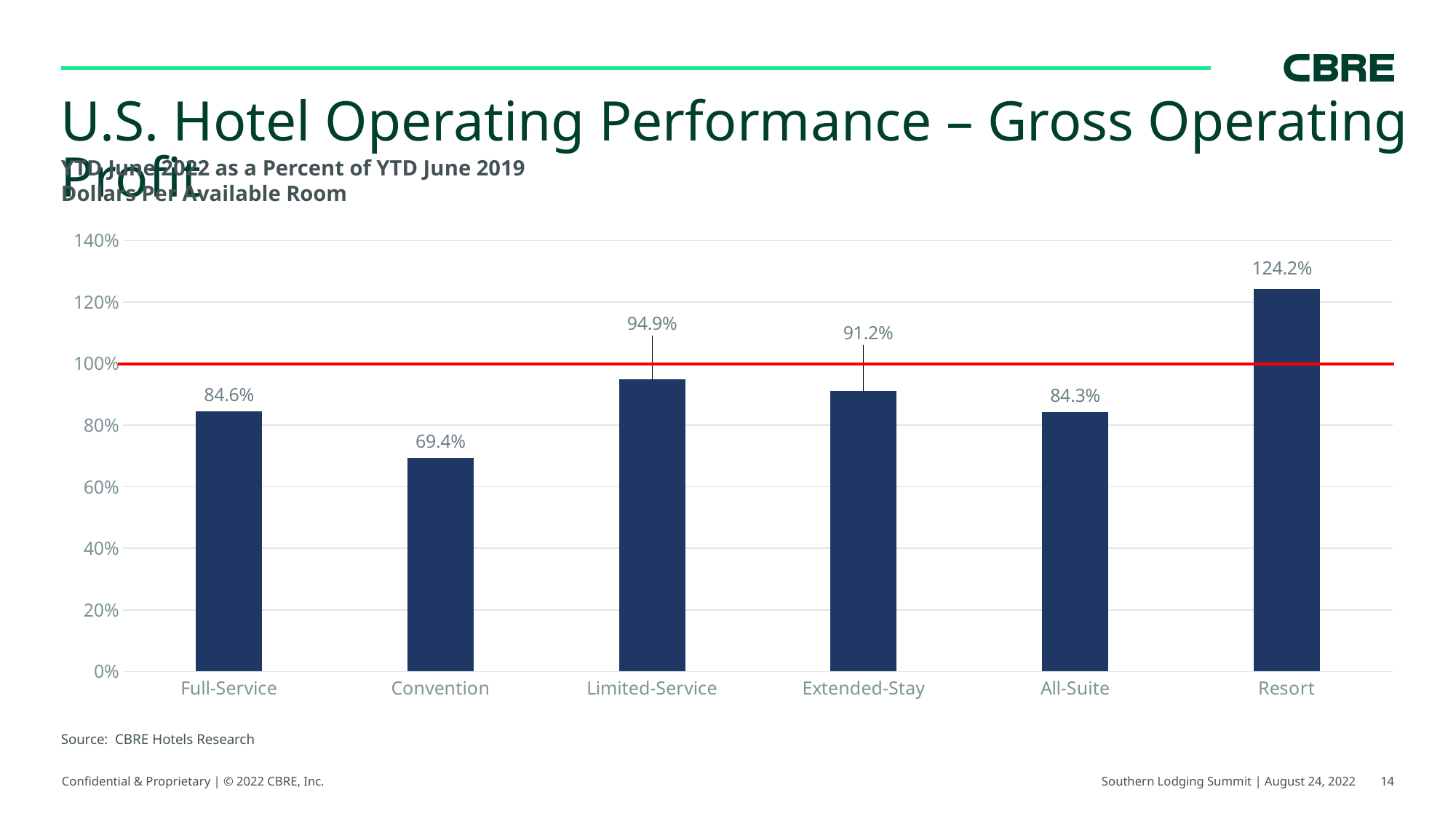
What is the value for Extended-Stay? 91.2% What kind of chart is shown on the slide? bar chart Which category has the highest value? Resort Which category has the lowest value? Convention Is the value for Resort greater or less than 100%? greater Which is larger, the value for Limited-Service or the value for All-Suite? Limited-Service What is the value for Convention? 69.4% What is the source cited below the chart? CBRE Hotels Research How many categories are shown on the x axis? 6 What is the difference between the values for Resort and Convention? 54.8% What is the value for Resort? 124.2% What is the difference between the values for Limited-Service and Extended-Stay? 3.7%